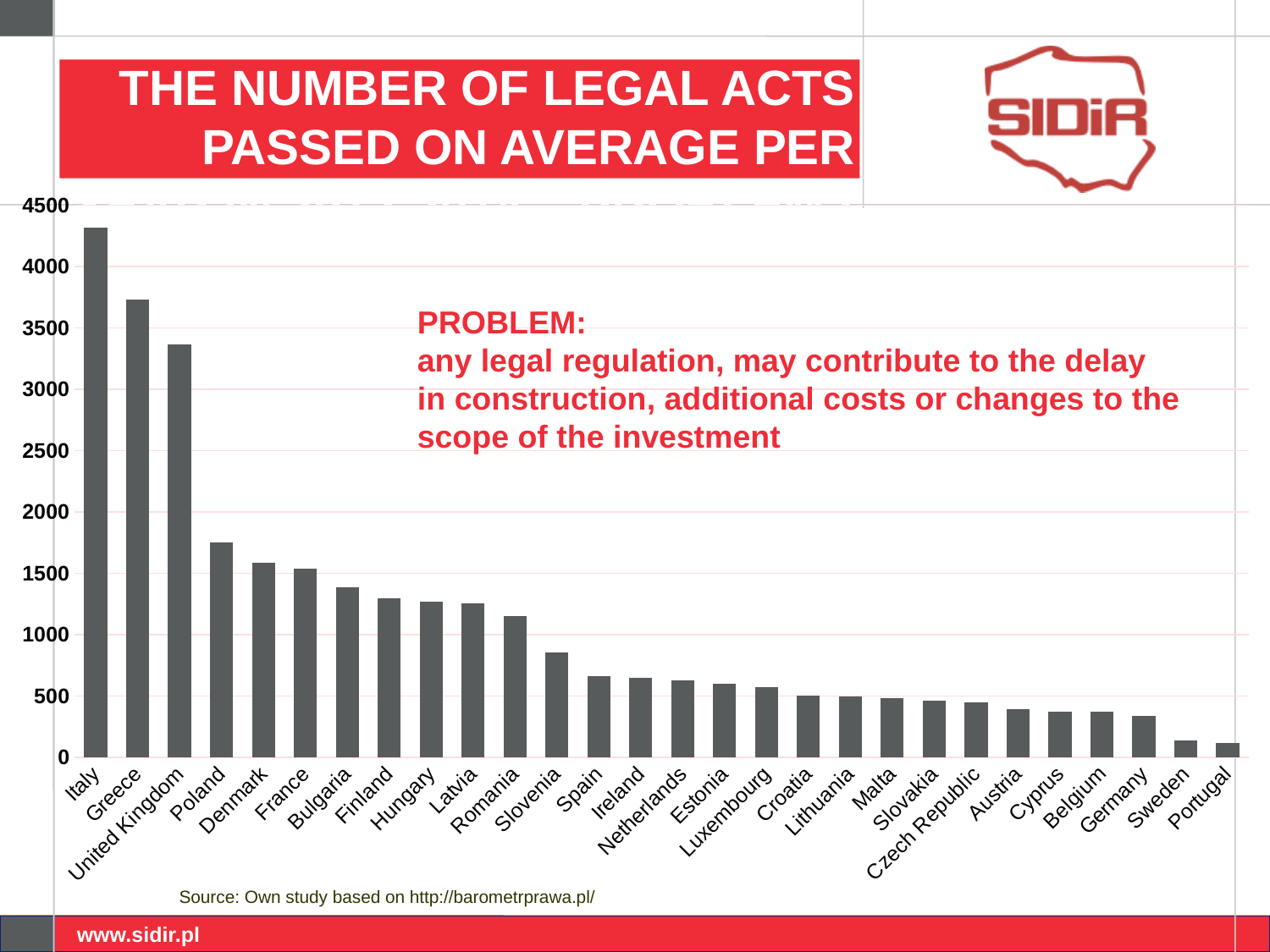
Which has a larger value, Greece or United Kingdom? Greece How many countries are shown in the chart? 28 Which country has the highest value in the chart? Italy Do the values rise or fall from left to right along the x axis? fall Is the value for Romania greater or less than 1000? greater What kind of chart is shown on the slide? bar chart Is the value for Germany greater or less than 500? less Is the value for Poland greater or less than 1500? greater Which has a larger value, Spain or Poland? Poland